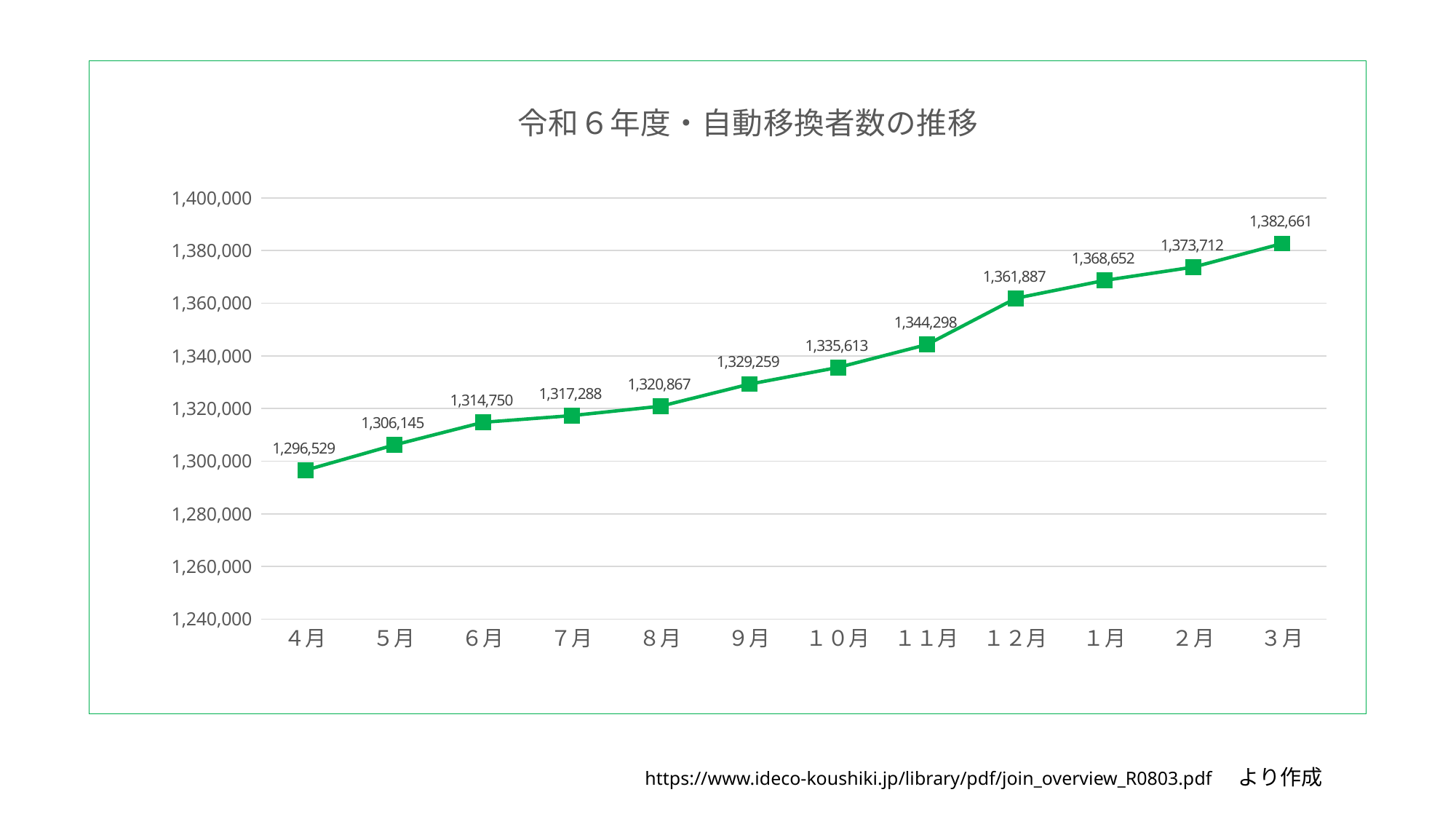
Which is larger, the value for 8月 or the value for 9月? 9月 Do the values rise or fall from 4月 to 3月? rise What is the value for 4月? 1,296,529 Which month has the lowest value? 4月 What is the value for 10月? 1,335,613 How many months are plotted on the chart? 12 What type of chart is shown on the slide? line chart Which month has the highest value? 3月 What is the title of the chart? 令和６年度・自動移換者数の推移 What is the difference between the values for 12月 and 11月? 17,589 What is the difference between the values for 3月 and 4月? 86,132 What is the value for 3月? 1,382,661